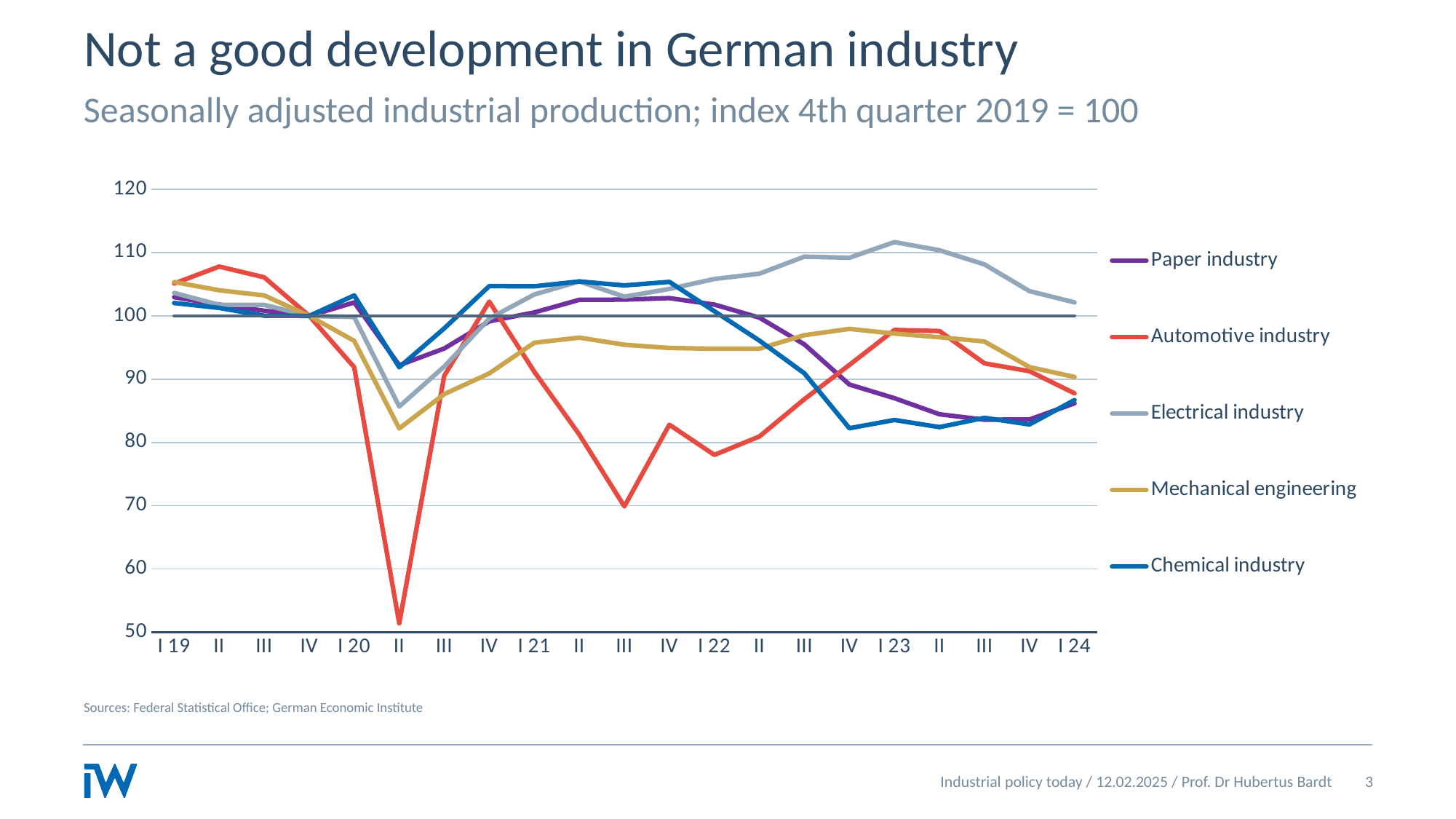
Which series has the lowest value in II 20? Automotive industry What is the index value of all series in IV 19? 100 Is the value for the Chemical industry in IV 22 greater or less than 90? less How many quarters are plotted along the x axis? 21 Does the Chemical industry line rise or fall from IV 21 to IV 22? fall Which series has the highest value in I 23? Electrical industry What colour is the Automotive industry line? red In I 24, which is higher: the Electrical industry or Mechanical engineering? Electrical industry Is the value for the Automotive industry in II 20 greater or less than 60? less How many series does the legend list? 5 What kind of chart is shown on the slide? line chart Is the value for the Electrical industry in I 23 greater or less than 110? greater